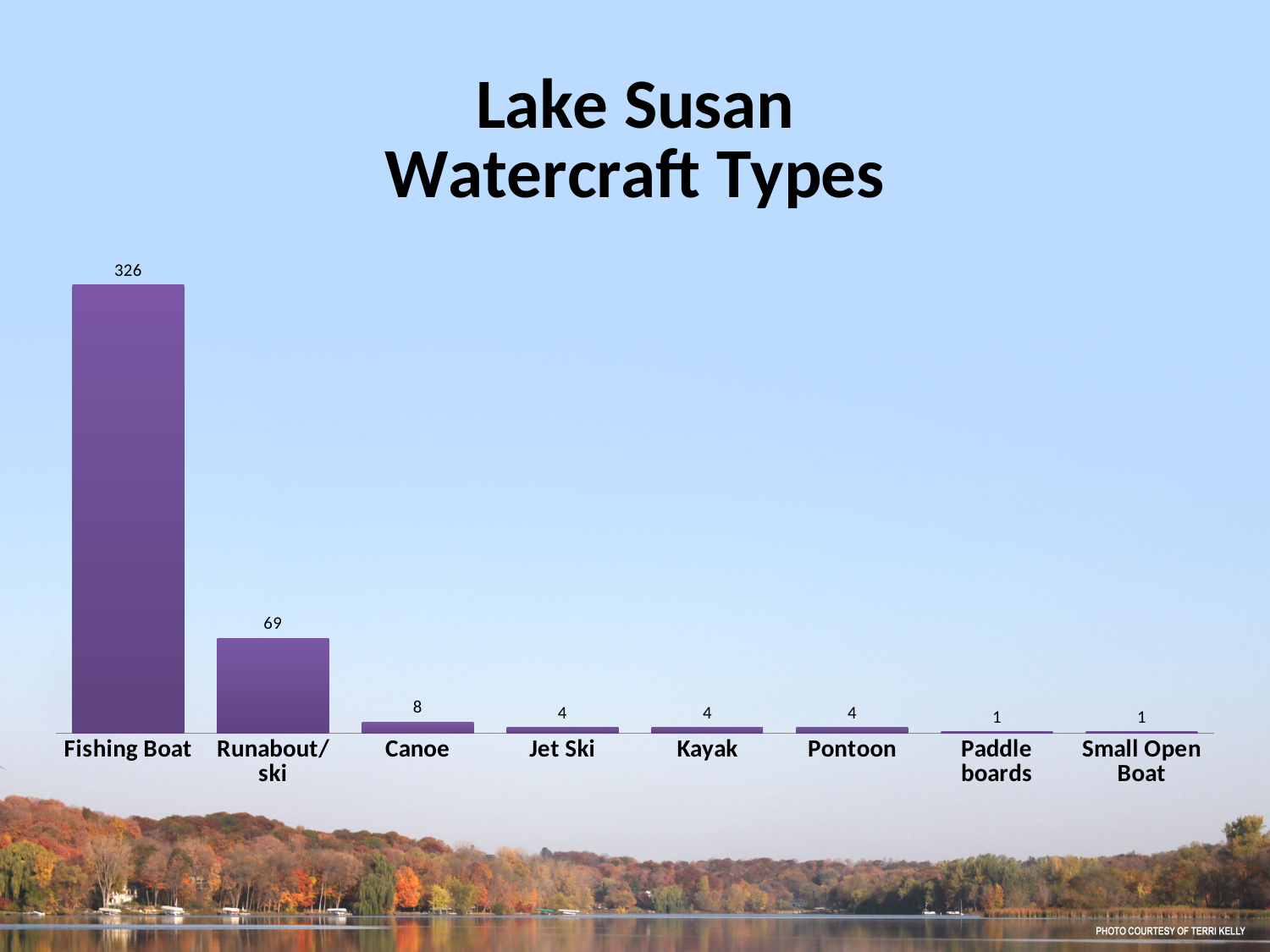
Which category has the highest value? Fishing Boat What is the difference between the values for Canoe and Jet Ski? 4 What is the value for Fishing Boat? 326 How many categories are shown on the x axis? 8 What is the title of the chart? Lake Susan Watercraft Types What is the value for Pontoon? 4 What kind of chart is shown on the slide? Bar chart What is the value for Runabout/ski? 69 What is the value for Canoe? 8 Do the values rise or fall from left to right along the x axis? Fall Which is larger, the value for Runabout/ski or the value for Canoe? Runabout/ski What is the difference between the values for Fishing Boat and Runabout/ski? 257